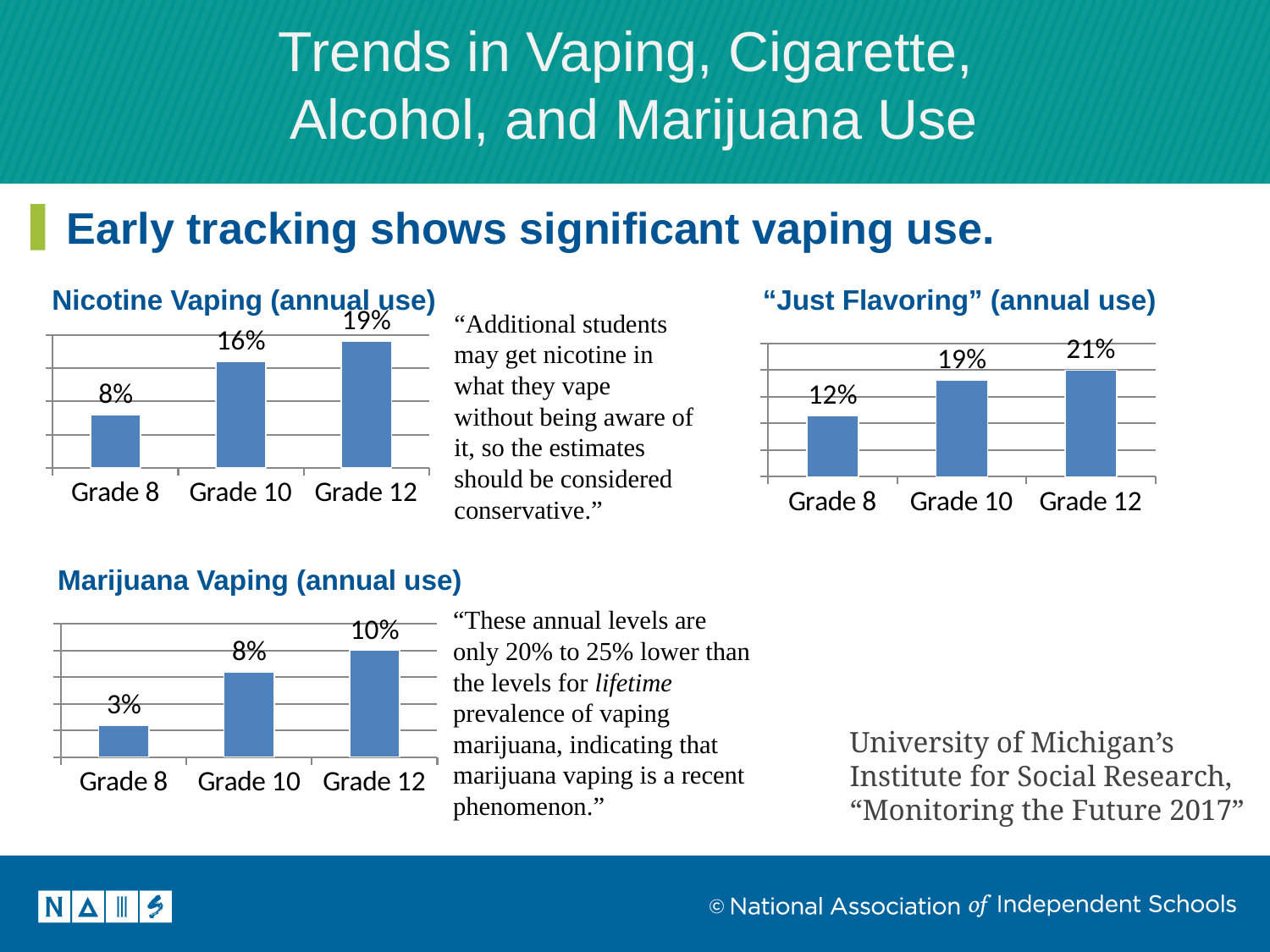
In the Marijuana Vaping (annual use) chart, which grade has the lowest value? Grade 8 In the Marijuana Vaping (annual use) chart, do the values rise or fall from Grade 8 to Grade 12? Rise In the Nicotine Vaping (annual use) chart, which grade has the highest value? Grade 12 How many grade categories are shown in the Marijuana Vaping (annual use) chart? 3 In the Nicotine Vaping (annual use) chart, what is the difference between the Grade 12 and Grade 10 values? 3% How many charts are shown on the slide? 3 In the "Just Flavoring" (annual use) chart, what is the difference between the Grade 12 and Grade 8 values? 9% In the "Just Flavoring" (annual use) chart, what is the value for Grade 8? 12% What kind of chart is the "Just Flavoring" (annual use) chart? Bar chart In the Marijuana Vaping (annual use) chart, what is the value for Grade 12? 10% In the Nicotine Vaping (annual use) chart, what is the value for Grade 10? 16% Which is larger: the Grade 10 value in the Nicotine Vaping chart or the Grade 10 value in the "Just Flavoring" chart? "Just Flavoring" Grade 10 (19%)